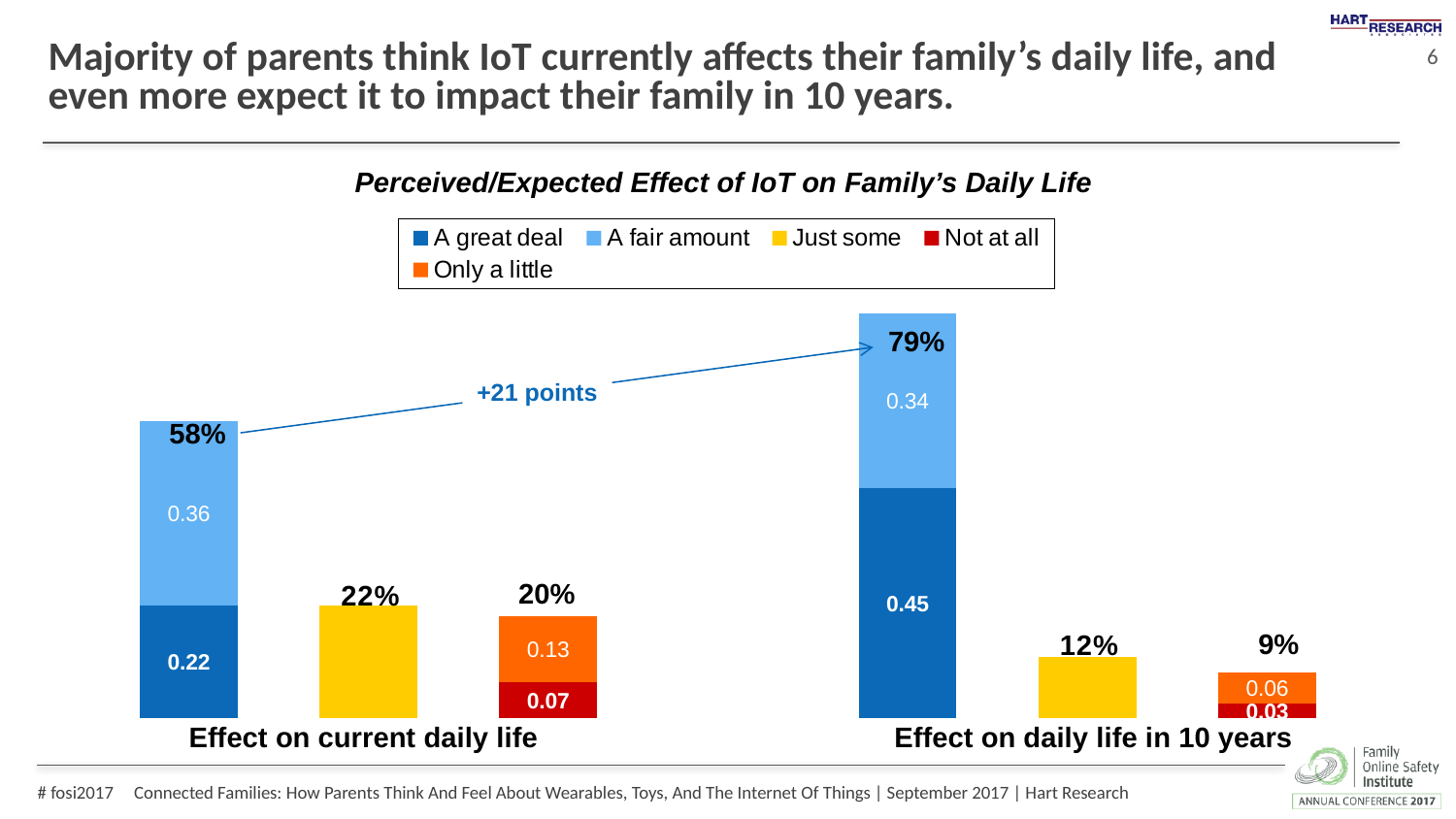
What is the value for 'Not at all' in the 'Effect on current daily life' group? 0.07 What is the combined total shown for 'A great deal' plus 'A fair amount' in the 'Effect on current daily life' group? 58% What kind of chart is shown on the slide? stacked bar chart What is the combined total shown for 'A great deal' plus 'A fair amount' in the 'Effect on daily life in 10 years' group? 79% What is the value for 'A great deal' in the 'Effect on current daily life' group? 0.22 How many series does the legend list? 5 What change in points is annotated by the arrow between the 58% and 79% bars? +21 points Which is larger: the 'Just some' value for 'Effect on current daily life' or for 'Effect on daily life in 10 years'? Effect on current daily life What is the difference between the 'A great deal' values for 'Effect on daily life in 10 years' and 'Effect on current daily life'? 0.23 What is the value for 'A fair amount' in the 'Effect on daily life in 10 years' group? 0.34 What is the title of the chart? Perceived/Expected Effect of IoT on Family's Daily Life What is the value for 'Just some' in the 'Effect on daily life in 10 years' group? 12%